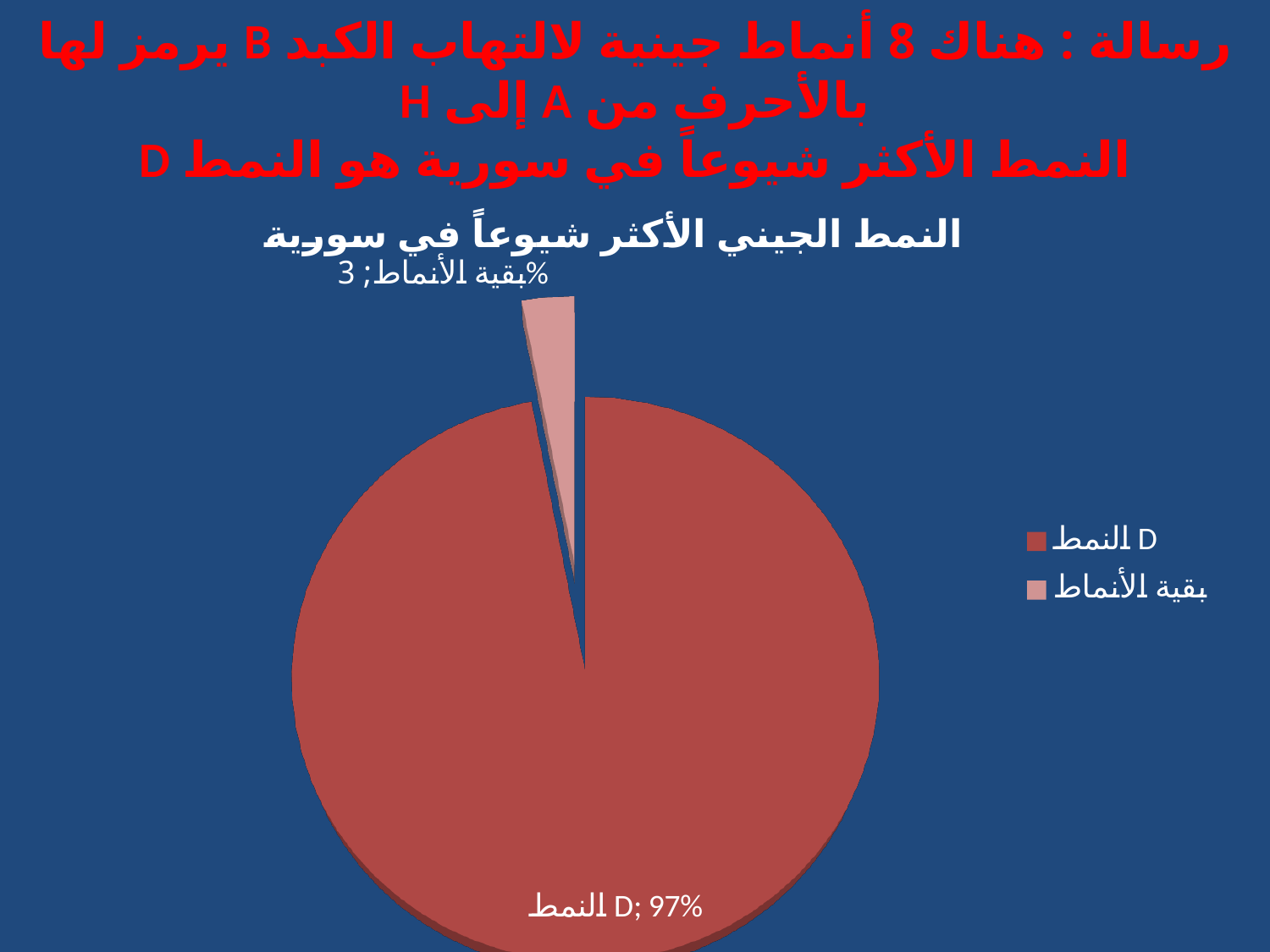
How many entries does the legend list? 2 What kind of chart is shown on the slide? pie chart What is the value shown for النمط D? 97% Which slice of the pie is the largest? النمط D Which legend entry is shown in the lighter pink colour? بقية الأنماط What share of the pie does النمط D take? 97% What is the difference between the values for النمط D and بقية الأنماط? 94% What is the title of the chart? النمط الجيني الأكثر شيوعاً في سورية Which is larger, the value for النمط D or the value for بقية الأنماط? النمط D How many slices does the pie chart have? 2 Which slice of the pie is the smallest? بقية الأنماط What is the value shown for بقية الأنماط? 3%